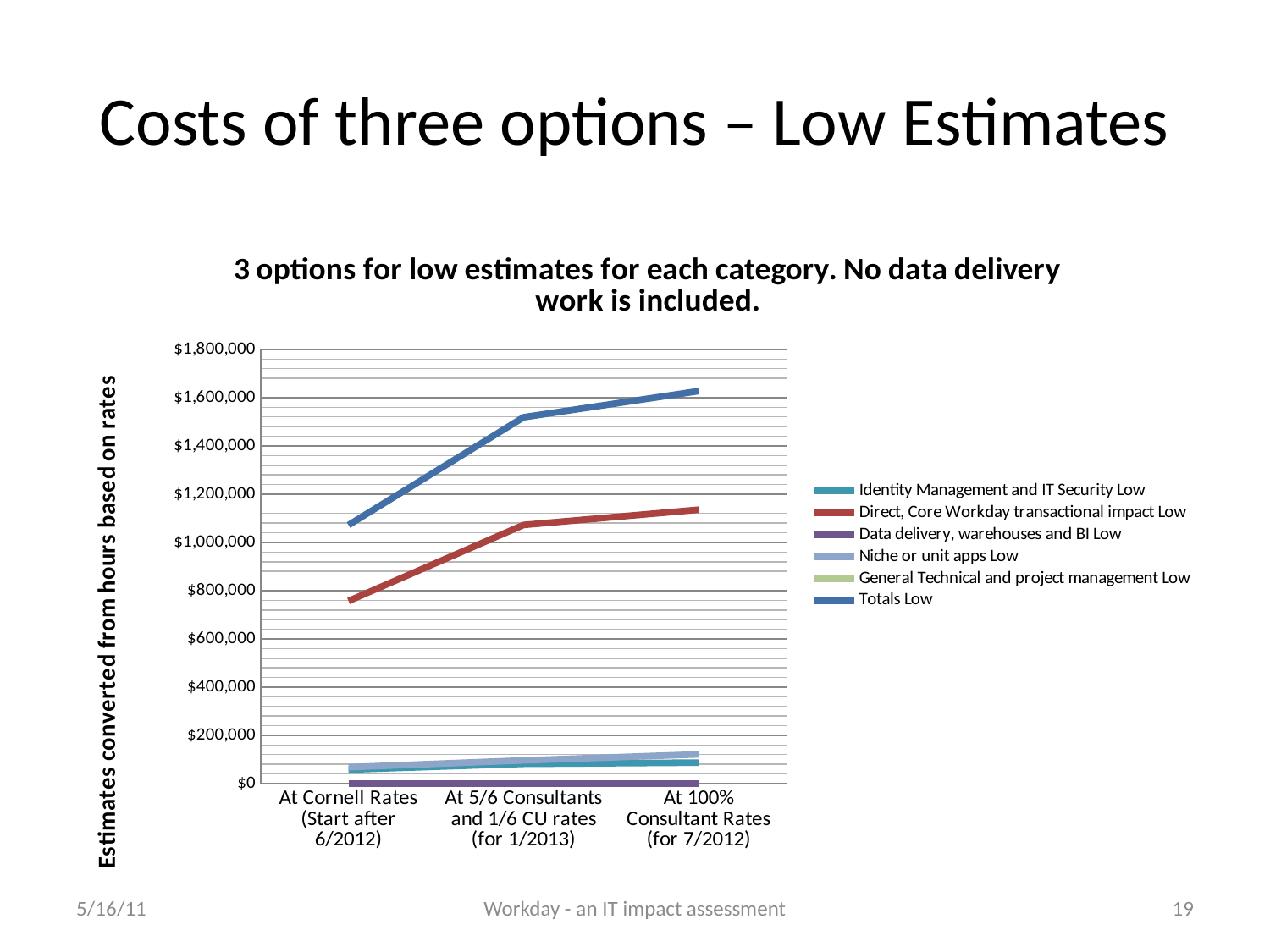
Does the Totals Low series rise or fall from 'At Cornell Rates' to 'At 100% Consultant Rates'? rise What is the title of the chart? 3 options for low estimates for each category. No data delivery work is included. Which is larger at 'At 5/6 Consultants and 1/6 CU rates': Totals Low or Direct, Core Workday transactional impact Low? Totals Low How many series does the legend list? 6 Does the Direct, Core Workday transactional impact Low series rise or fall across the three options? rise Which series has the highest values across all three options? Totals Low What kind of chart is shown on the slide? line chart How many categories are shown along the x axis? 3 Is the Totals Low value at 'At Cornell Rates (Start after 6/2012)' greater or less than $1,000,000? greater Is the Direct, Core Workday transactional impact Low value at 'At Cornell Rates' greater or less than $800,000? less Is the Niche or unit apps Low value at 'At 100% Consultant Rates' greater or less than $200,000? less